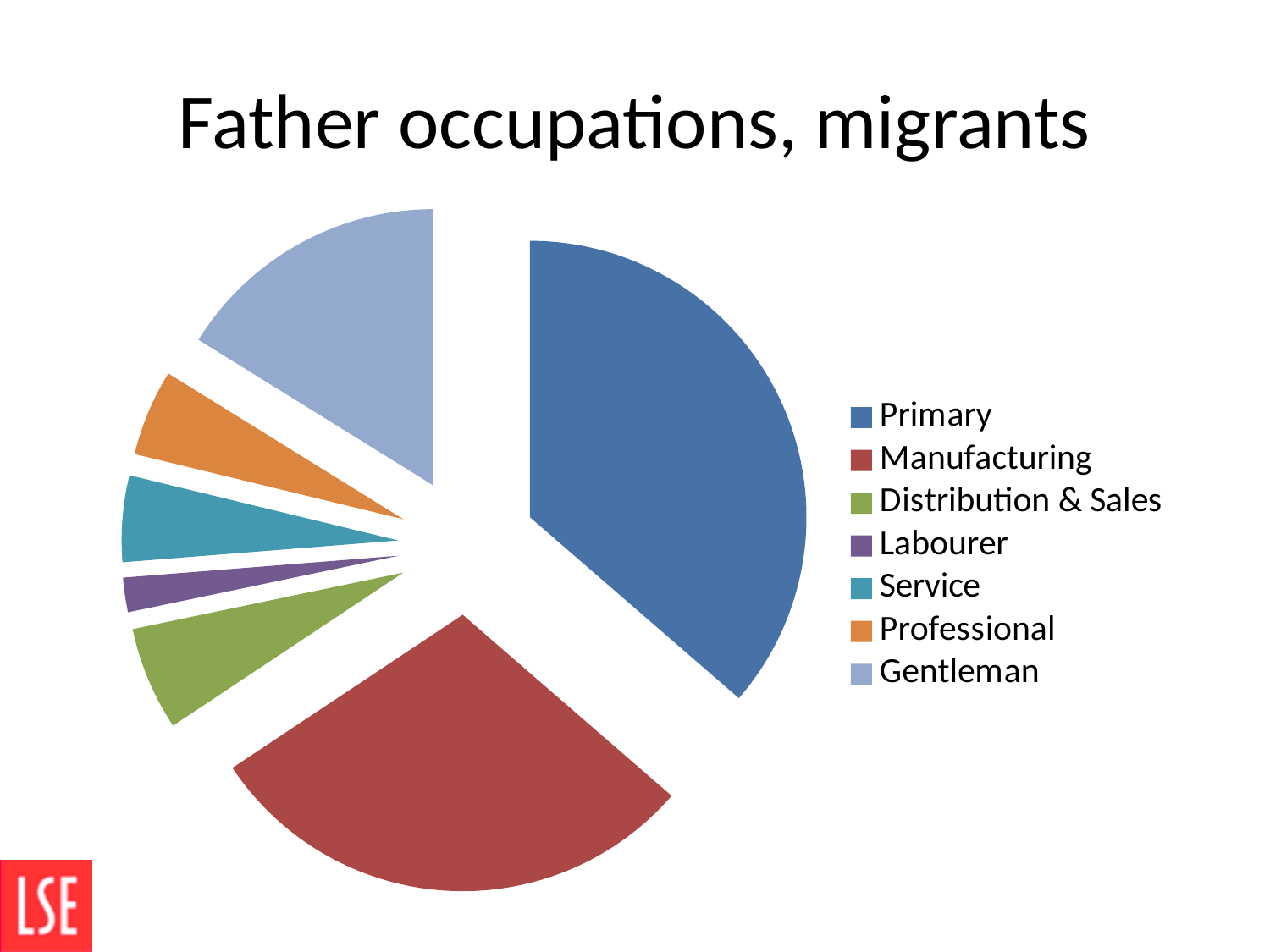
Which slice is larger, Gentleman or Professional? Gentleman What kind of chart is shown on the slide? pie chart Which slice is larger, Service or Labourer? Service Which slice is larger, Distribution & Sales or Labourer? Distribution & Sales How many slices (categories) does the pie chart have? 7 What is the title of the chart? Father occupations, migrants Which category has the smallest slice of the pie? Labourer Which category is shown in the orange slice? Professional Which category has the largest slice of the pie? Primary